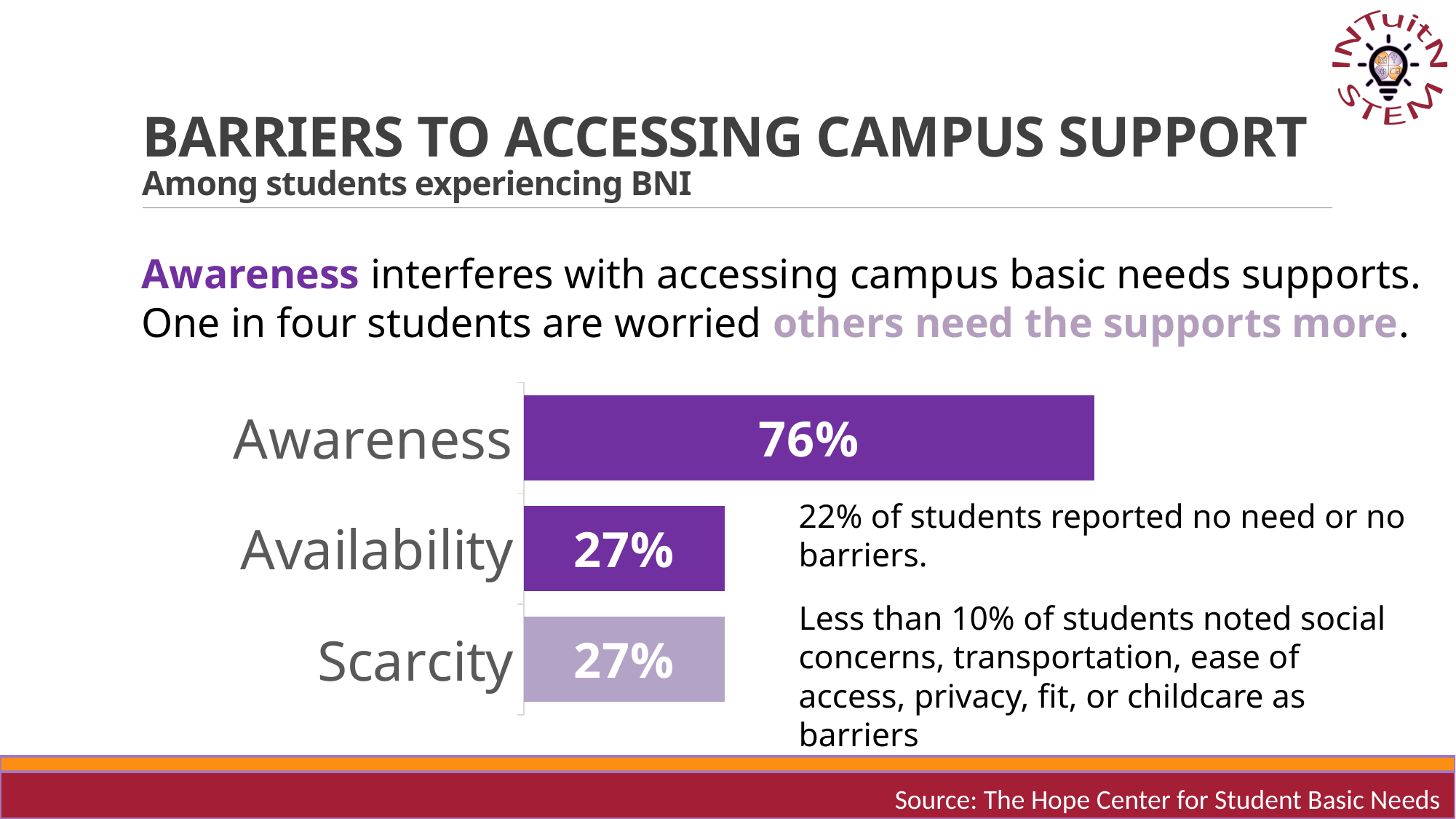
Which is larger, the value for Awareness or the value for Scarcity? Awareness What is the title of the slide containing the chart? BARRIERS TO ACCESSING CAMPUS SUPPORT What is the value for Availability? 27% What is the difference between the values for Awareness and Availability? 49 percentage points What is the value for Scarcity? 27% Which category has the highest value? Awareness How many categories are shown in the chart? 3 Which category's bar is shown in a lighter purple shade than the others? Scarcity Do the values for Availability and Scarcity differ? No, both are 27% What is the value for Awareness? 76% What kind of chart is shown on the slide? Bar chart